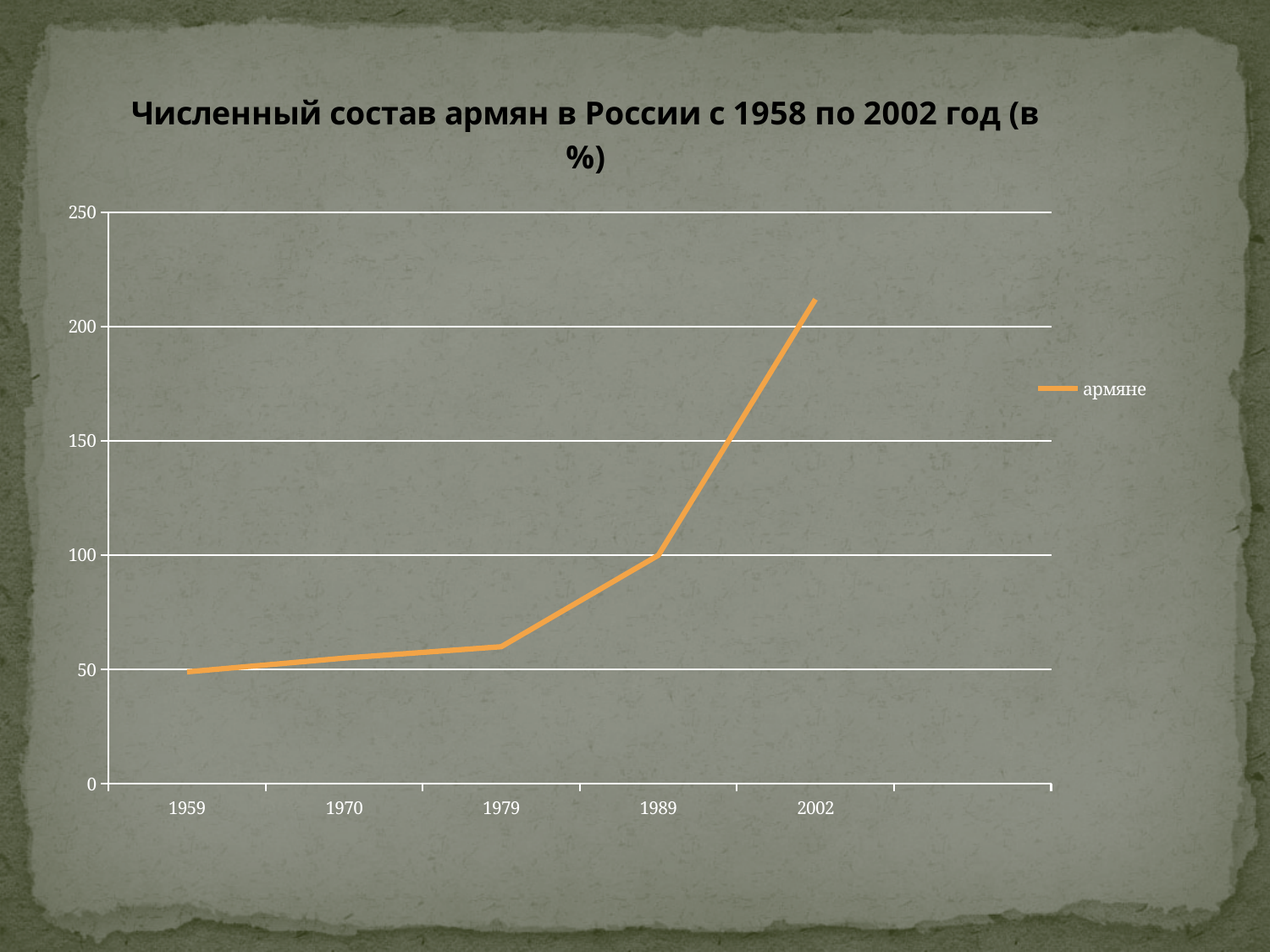
What is the title of the chart? Численный состав армян в России с 1958 по 2002 год (в %) What kind of chart is shown on the slide? line chart Do the values rise or fall from 1959 to 2002? rise Is the value for 1979 greater or less than 100? less Is the value for 2002 greater or less than 200? greater What is the name of the series shown in the legend? армяне How many series does the legend list? 1 Which year has the lowest value? 1959 How many years are plotted along the x axis? 5 Is the value for 1989 greater or less than 150? less Which is larger, the value for 2002 or the value for 1989? 2002 Which year has the highest value? 2002